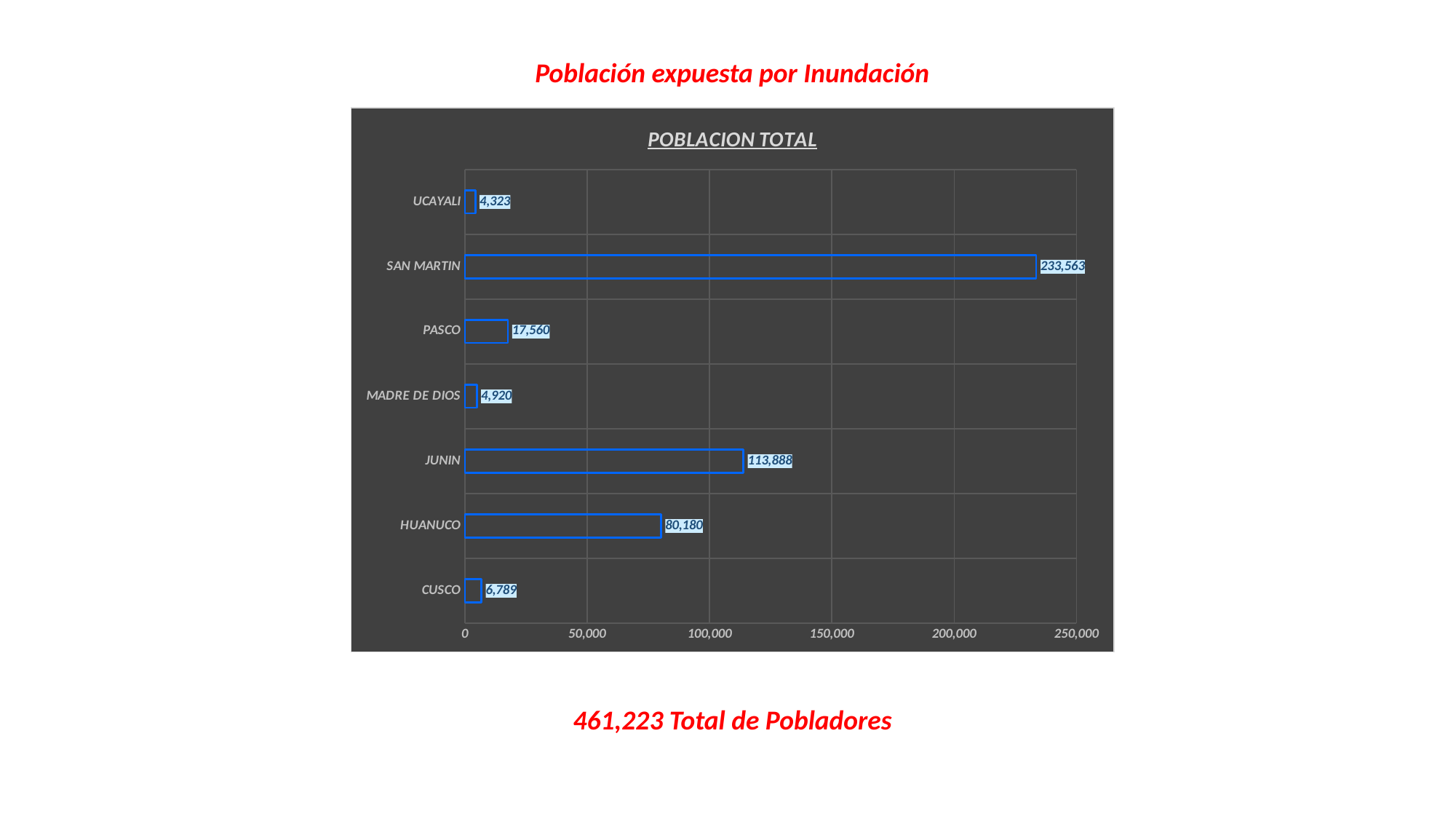
What is the value for SAN MARTIN? 233,563 Which category has the lowest value? UCAYALI What is the value for JUNIN? 113,888 What is the difference between the values for SAN MARTIN and JUNIN? 119,675 What is the value for PASCO? 17,560 Which category has the highest value? SAN MARTIN What is the value for HUANUCO? 80,180 What is the title of the chart? POBLACION TOTAL Which is larger, the value for HUANUCO or the value for PASCO? HUANUCO How many categories are shown in the chart? 7 Is the value for JUNIN greater or less than 100,000? greater What kind of chart is shown? bar chart